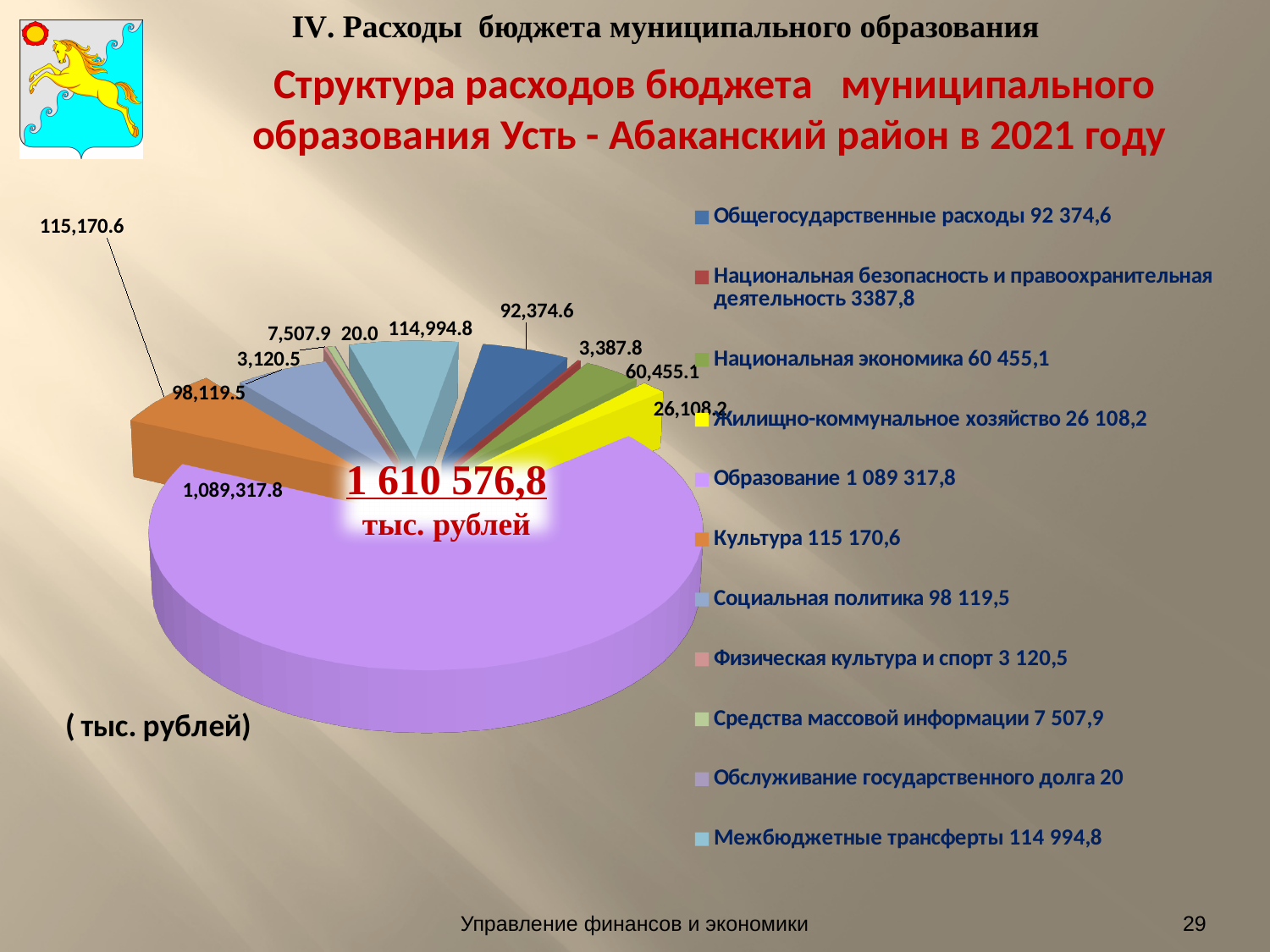
What is the value for Обслуживание государственного долга on the pie chart? 20.0 What is the difference between the values for Культура and Социальная политика? 17,051.1 What is the value for Образование (Education) on the pie chart? 1,089,317.8 Which is larger: the value for Жилищно-коммунальное хозяйство or the value for Национальная экономика? Национальная экономика Which category has the largest slice of the pie chart? Образование What kind of chart is shown on the slide? pie chart What is the value for Межбюджетные трансферты on the pie chart? 114,994.8 Which category has the smallest slice of the pie chart? Обслуживание государственного долга What total amount is printed in the centre of the pie chart? 1 610 576,8 тыс. рублей How many categories does the legend of the pie chart list? 11 What is the difference between the values for Общегосударственные расходы and Национальная экономика? 31,919.5 What is the value for Культура (Culture) on the pie chart? 115,170.6